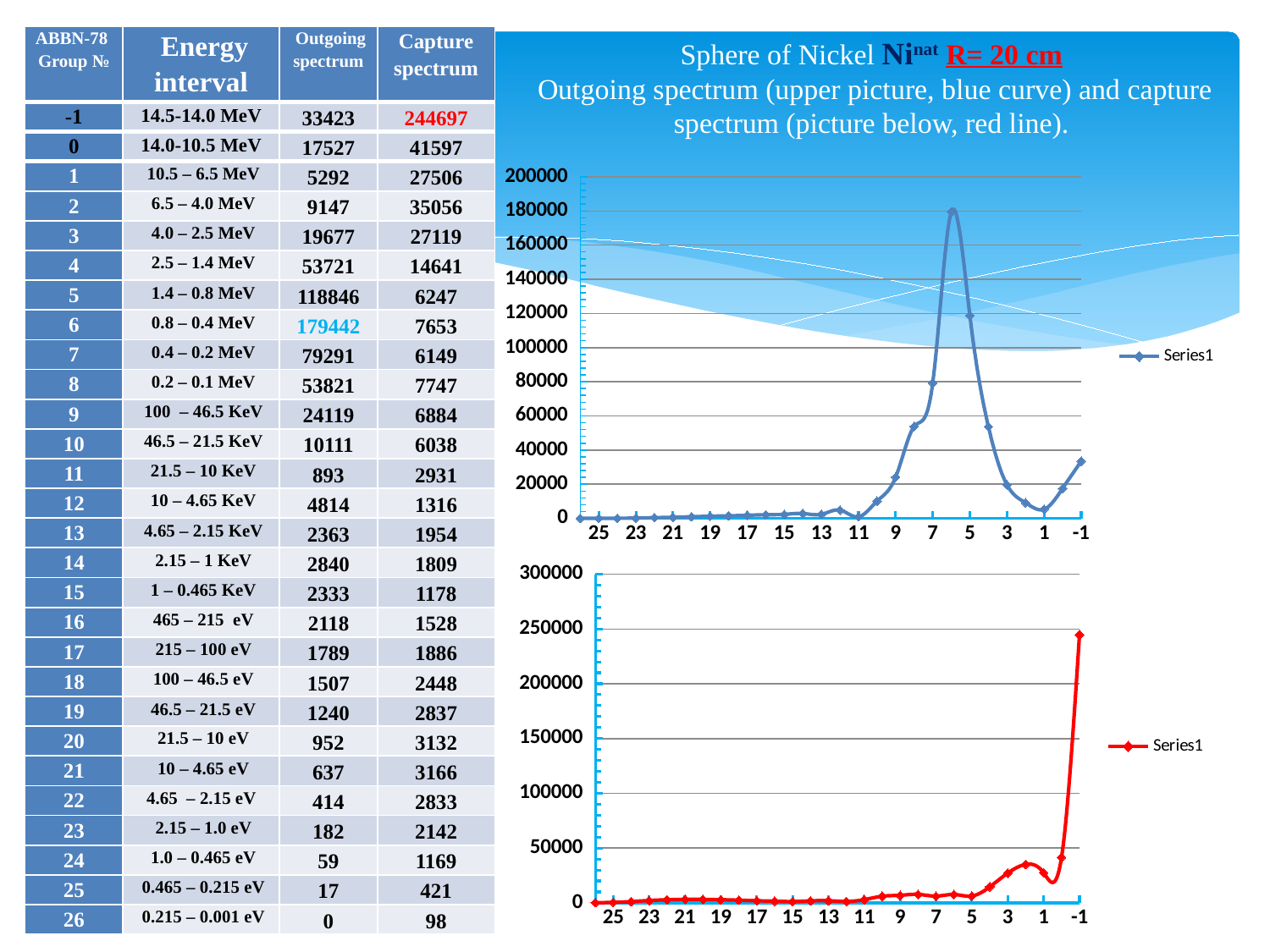
In the lower chart, is the value at x = 3 greater or less than 50000? less What colour is the line in the lower chart? red What is the legend entry shown for the upper chart? Series1 In the lower chart, at which x-axis label does the curve reach its highest value? -1 In the lower chart, which is larger: the value at x = -1 or the value at x = 3? x = -1 What kind of chart is the upper chart on the slide? line chart How many series does the legend of the lower chart list? 1 In the upper chart, is the value at x = 11 greater or less than 20000? less In the lower chart, is the value at x = -1 greater or less than 200000? greater